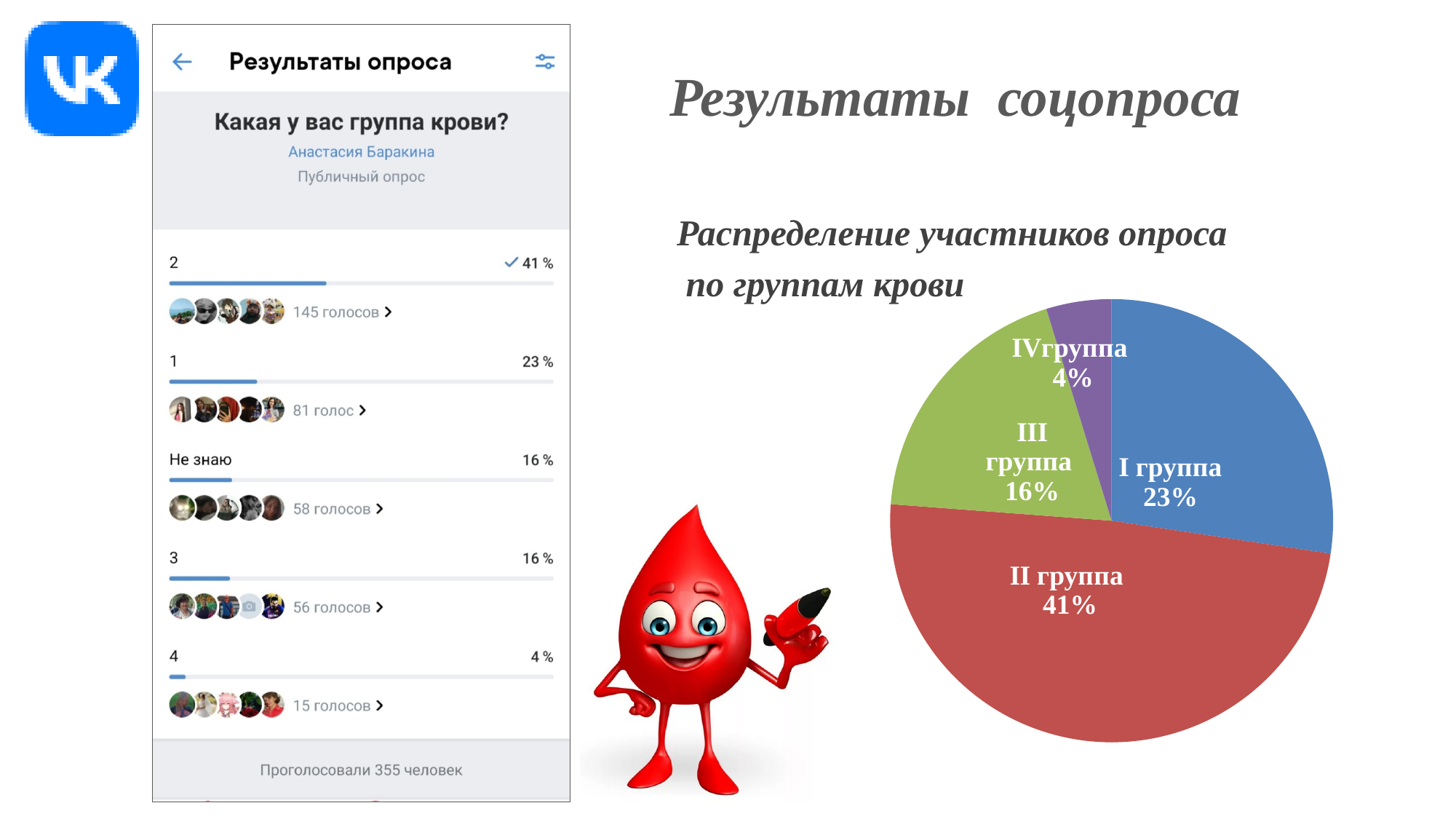
How many slices does the pie chart have? 4 By how many percentage points does II группа exceed I группа in the pie chart? 18 Which blood group has the smallest slice in the pie chart? IV группа By how many percentage points does III группа exceed IV группа in the pie chart? 12 What type of chart is used to show the distribution of participants by blood group? pie chart Which slice is larger in the pie chart, I группа or III группа? I группа Which blood group has the largest slice in the pie chart? II группа What colour is the II группа slice in the pie chart? red What percentage is shown for IV группа in the pie chart? 4% What share of the pie chart is labelled II группа? 41% What percentage is shown for I группа in the pie chart? 23% What percentage is shown for III группа in the pie chart? 16%